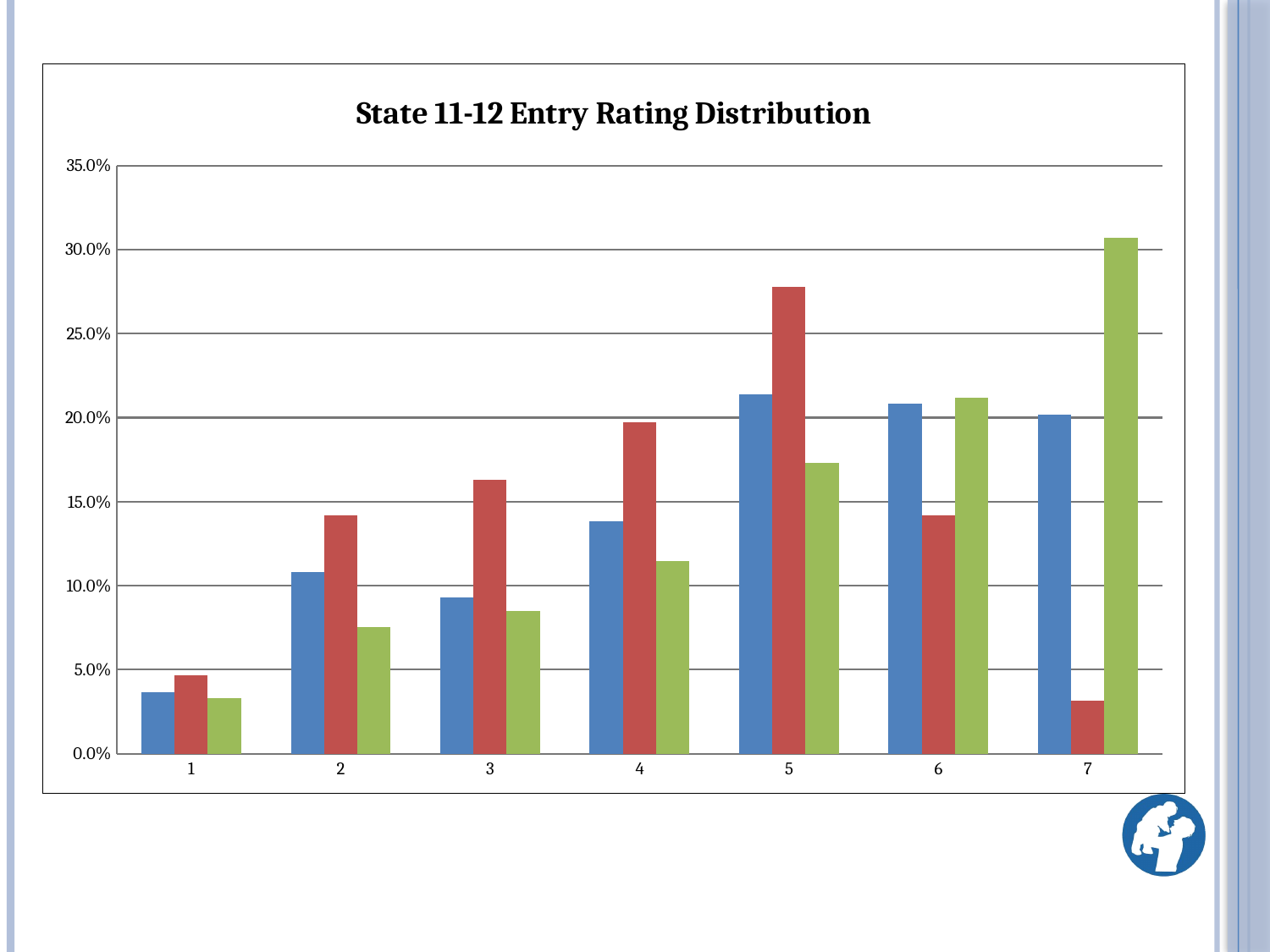
Which category has the shortest green bar? 1 Is the value of the red bar for category 5 greater or less than 25.0%? greater What is the title of the chart? State 11-12 Entry Rating Distribution Which category has the tallest red bar? 5 Is the value of the green bar for category 4 greater or less than 10.0%? greater For category 7, which is larger, the green bar or the red bar? the green bar Is the value of the red bar for category 7 greater or less than 5.0%? less Which category has the tallest green bar? 7 Do the green bars rise or fall as you move from category 1 to category 7? rise How many categories are shown along the x axis? 7 What kind of chart is shown on the slide? bar chart How many bars are plotted for each category on the x axis? 3